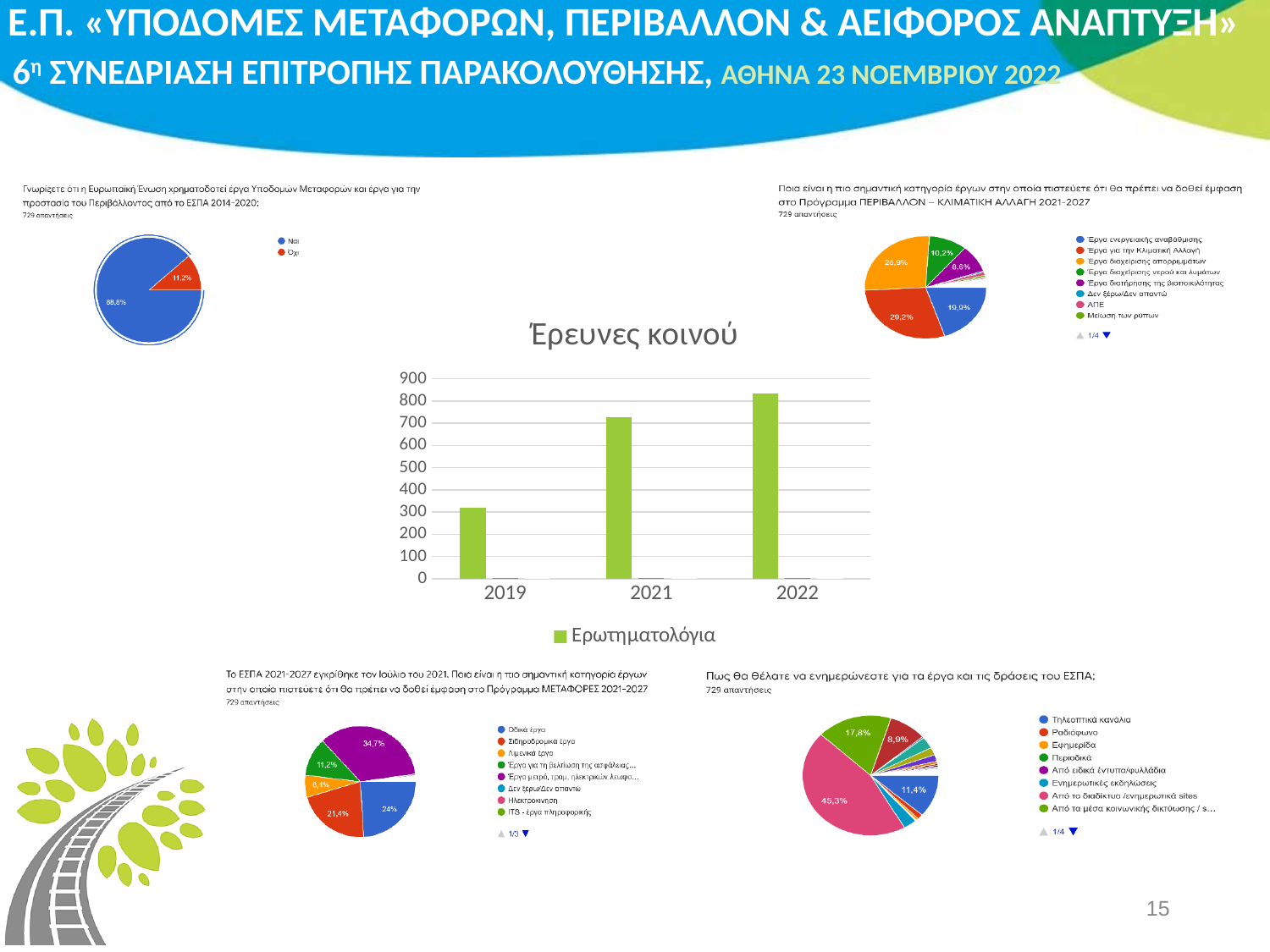
In the "Έρευνες κοινού" bar chart, which year has the highest value? 2022 In the "Έρευνες κοινού" bar chart, how many series does the legend list? 1 In the top-left pie chart about whether respondents know the EU funds transport and environment projects from ΕΣΠΑ 2014-2020, what share answered "Ναι"? 88,8% What kind of chart is the central chart titled "Έρευνες κοινού"? bar chart In the "Έρευνες κοινού" bar chart, is the value for 2021 greater or less than 600? greater In the "Έρευνες κοινού" bar chart, is the value for 2019 greater or less than 400? less In the "Έρευνες κοινού" bar chart, is the value for 2022 greater or less than 800? greater In the "Έρευνες κοινού" bar chart, what is the name of the series in the legend? Ερωτηματολόγια In the "Έρευνες κοινού" bar chart, which year has the larger value, 2021 or 2022? 2022 In the "Έρευνες κοινού" bar chart, do the values rise or fall from 2019 to 2022? rise In the "Έρευνες κοινού" bar chart, how many years are shown on the x axis? 3 In the "Έρευνες κοινού" bar chart, which year has the lowest value? 2019